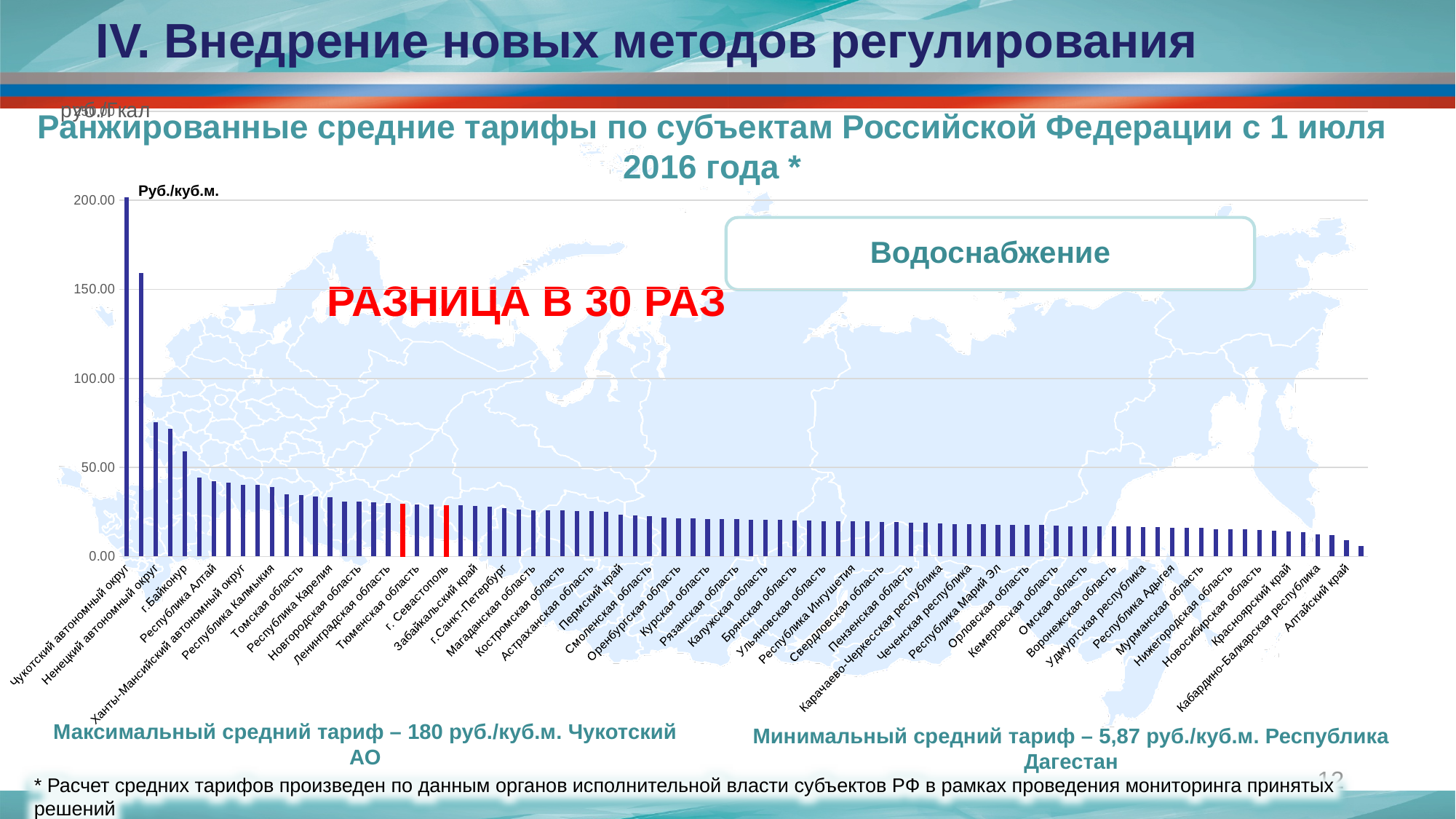
What unit is shown on the vertical axis of the chart? Руб./куб.м. Is the value for г.Байконур greater or less than 50? greater Is the value for Ненецкий автономный округ greater or less than 150? less Which has the larger value, Ненецкий автономный округ or г.Байконур? Ненецкий автономный округ Which region has the highest average tariff in the chart? Чукотский автономный округ Which has the larger value, Томская область or Курская область? Томская область What kind of chart is shown on the slide? bar chart Is the value for Алтайский край greater or less than 50? less Which region has the lowest average tariff according to the slide? Республика Дагестан What minimum average tariff does the slide state for Республика Дагестан? 5,87 руб./куб.м. Do the bar values rise or fall from left to right along the x axis? fall